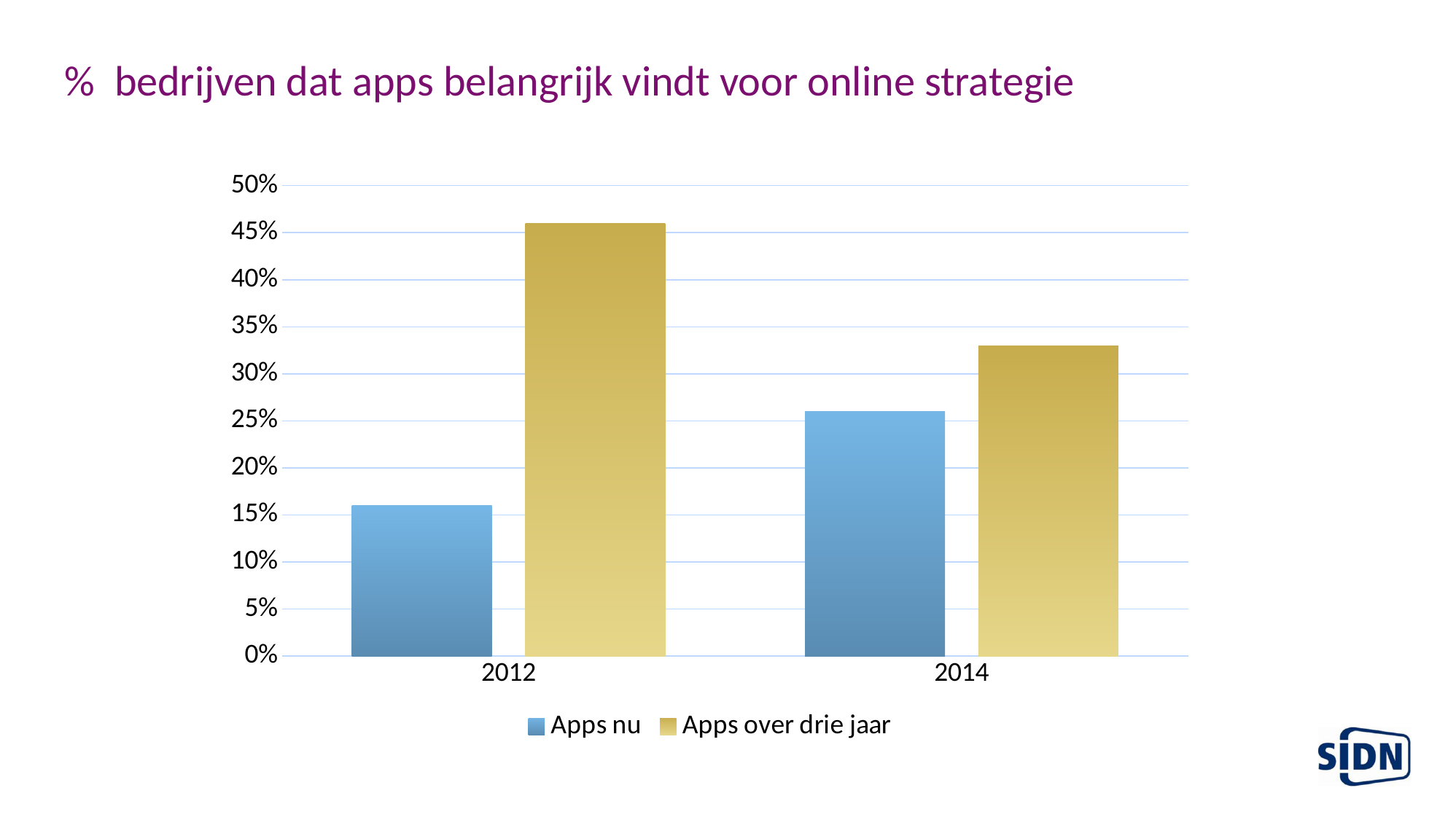
Is the value for Apps over drie jaar in 2014 greater or less than 35%? less How many categories are shown on the x axis? 2 Is the value for Apps nu in 2012 greater or less than 20%? less What kind of chart is shown on the slide? bar chart How many series does the legend list? 2 Does the value for Apps over drie jaar rise or fall from 2012 to 2014? fall Is the value for Apps over drie jaar in 2012 greater or less than 40%? greater Which is larger in 2014, Apps nu or Apps over drie jaar? Apps over drie jaar What is the title of the chart? % bedrijven dat apps belangrijk vindt voor online strategie Which series has the highest bar in the chart? Apps over drie jaar Which bar is the lowest in the chart? Apps nu in 2012